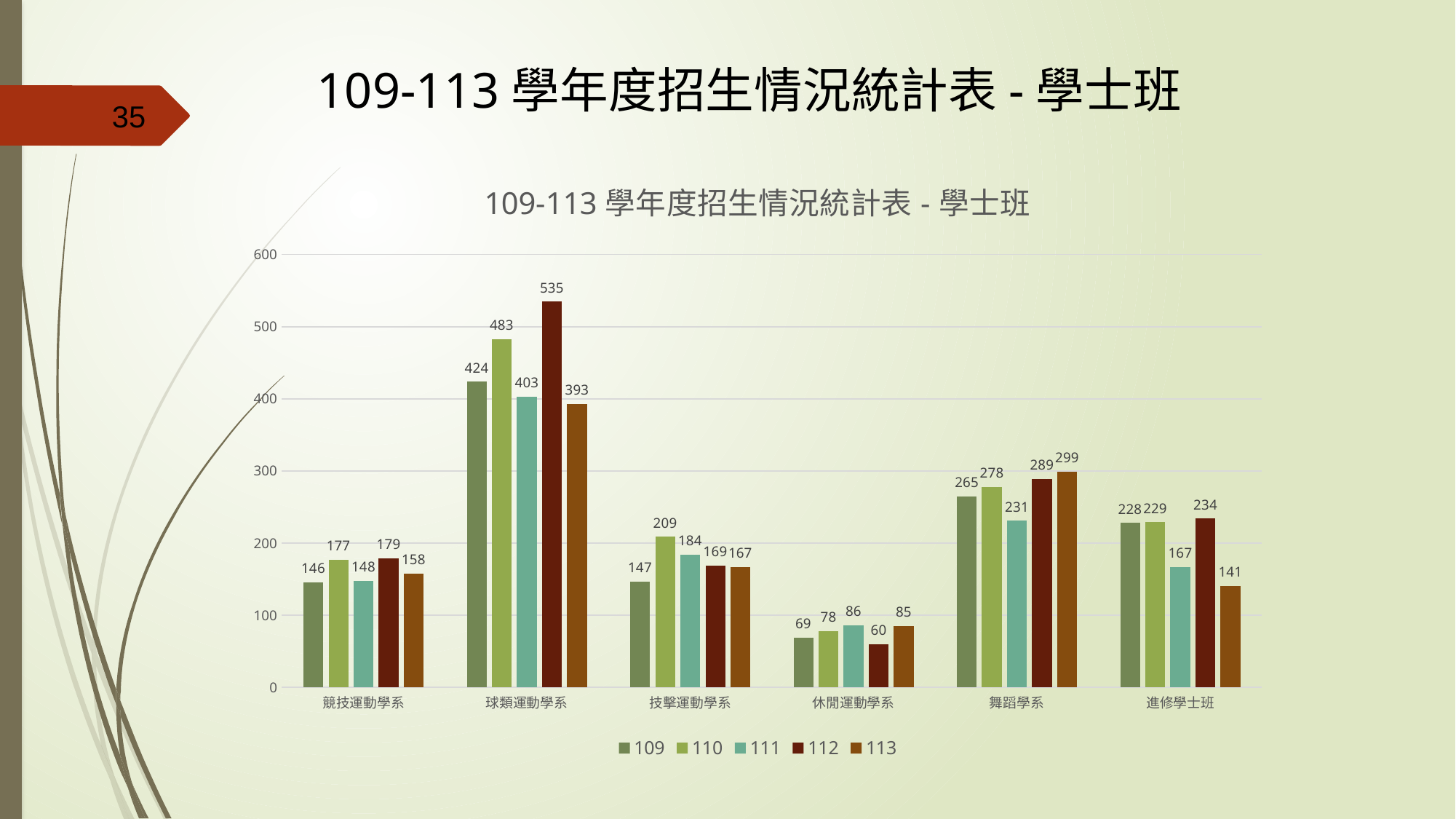
What is the value for 休閒運動學系 in series 109? 69 What is the value for 球類運動學系 in series 112? 535 What is the title of the chart? 109-113 學年度招生情況統計表 - 學士班 Which is larger for 舞蹈學系: the value for 109 or the value for 113? 113 What is the value for 進修學士班 in series 113? 141 What is the difference between the 112 and 113 values for 球類運動學系? 142 What kind of chart is shown on the slide? bar chart How many series does the legend list? 5 Which category has the highest value in series 110? 球類運動學系 Do the values for 舞蹈學系 rise or fall from series 109 to series 113? rise Which category has the lowest value in series 112? 休閒運動學系 How many categories are shown on the x axis? 6